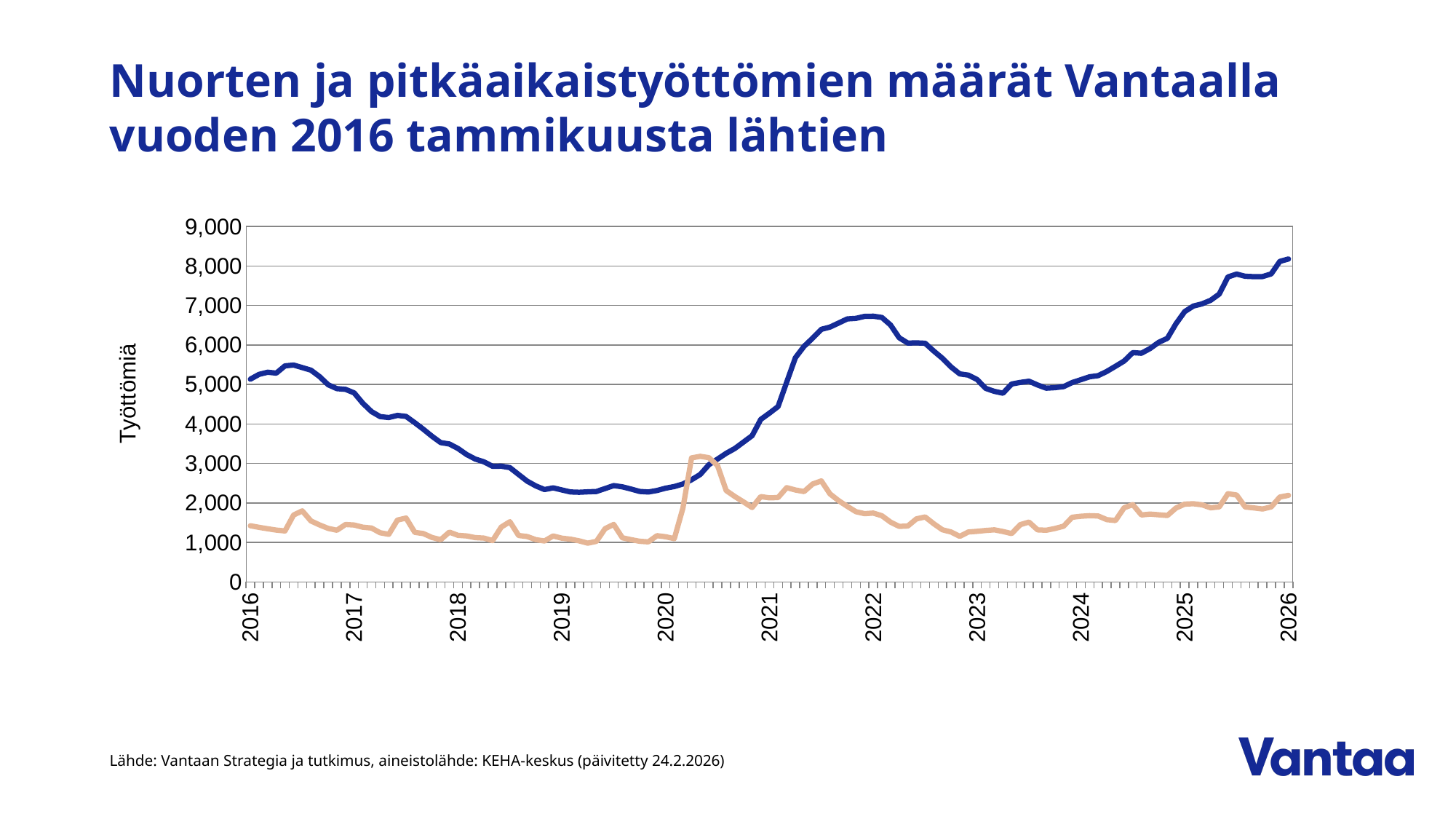
How many lines are plotted on the chart? 2 In which year on the x axis does the dark blue line reach its highest value? 2026 Is the peak of the light orange line in 2020 greater or less than 2,000? greater Is the value of the light orange line at the start of 2018 greater or less than 2,000? less Does the dark blue line rise or fall between 2016 and 2019? fall At the start of 2022, which line is higher, the dark blue line or the light orange line? dark blue line Is the value of the dark blue line at the start of 2016 greater or less than 4,000? greater Does the dark blue line rise or fall between 2023 and 2026? rise What kind of chart is shown on the slide? line chart What is the label on the y axis of the chart? Työttömiä